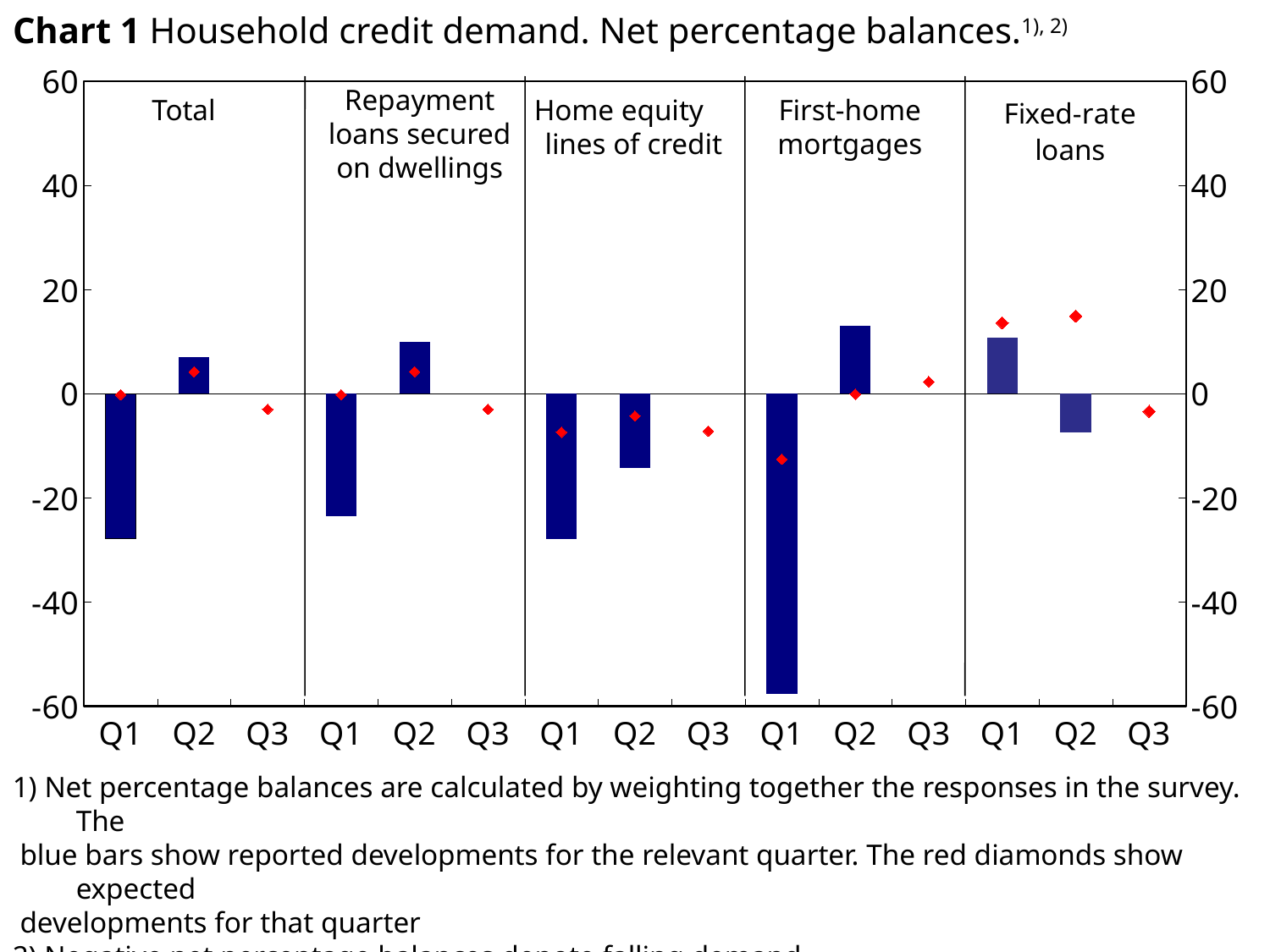
What kind of chart is Chart 1? bar chart Do the bars for Total rise or fall from Q1 to Q2? rise According to the footnote, what do the red diamonds in Chart 1 show? expected developments for that quarter Is the Q1 bar for Fixed-rate loans greater or less than 20? less Is the Q2 bar for Fixed-rate loans greater or less than 0? less Is the Q2 bar for Home equity lines of credit greater or less than -20? greater Which loan category has the lowest Q1 bar in Chart 1? First-home mortgages How many loan categories (panels) are shown in Chart 1? 5 For Home equity lines of credit, which bar is lower, Q1 or Q2? Q1 How many quarters are shown for each loan category in Chart 1? 3